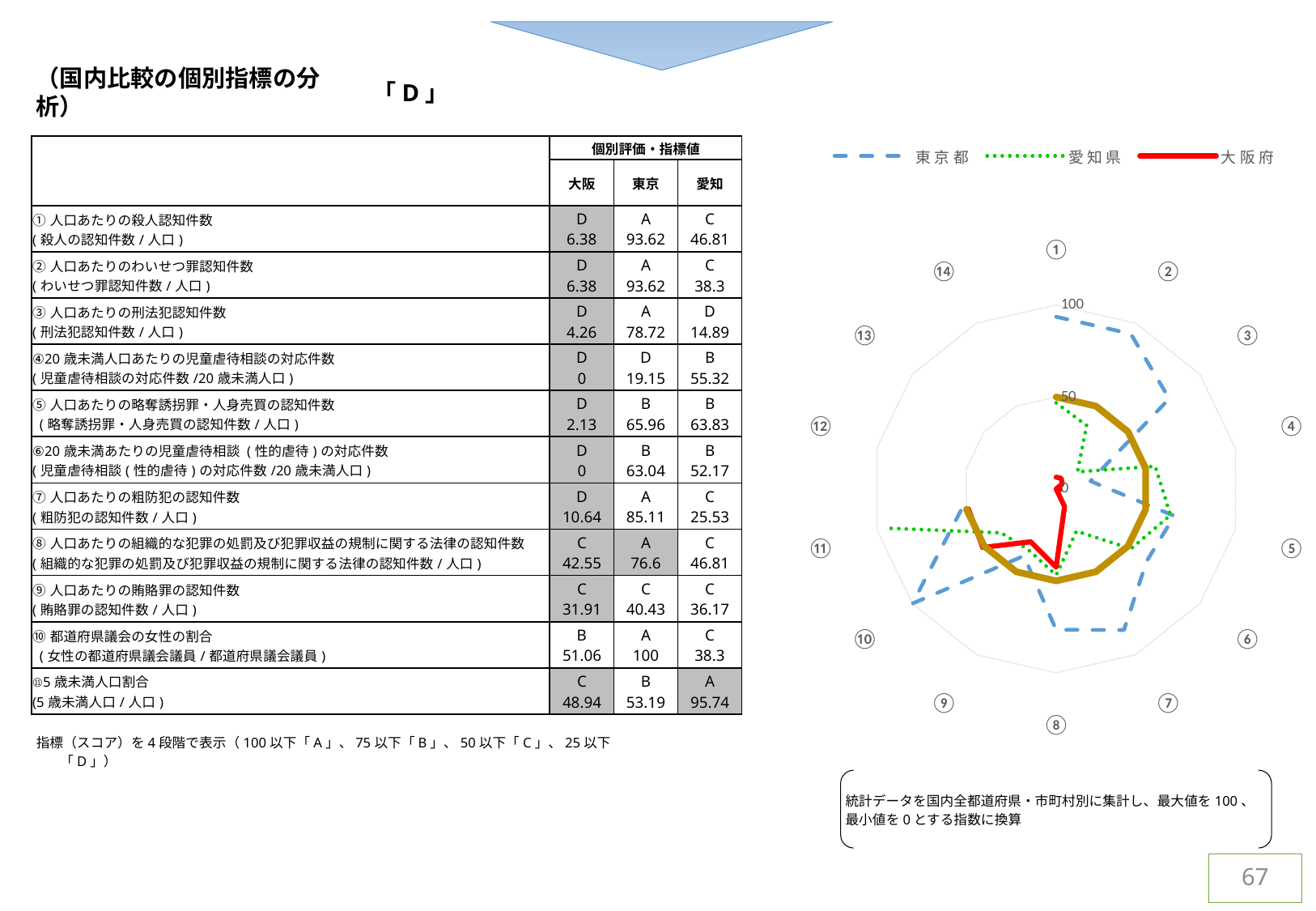
How many series does the legend of the radar chart list? 3 Which series are listed in the legend of the radar chart? 東京都, 愛知県, 大阪府 In the radar chart, which series has the larger value at category ①, 東京都 or 大阪府? 東京都 What kind of chart is shown on the right side of the slide? radar chart In the radar chart, is the value for 大阪府 at category ① greater or less than 50? less In the radar chart, is the value for 大阪府 at category ④ greater or less than 50? less In the radar chart, is the value for 愛知県 at category ⑪ greater or less than 50? greater In the radar chart, which series is drawn as a solid red line? 大阪府 In the radar chart, which series has the larger value at category ⑪, 愛知県 or 大阪府? 愛知県 How many numbered categories (axes) does the radar chart have? 14